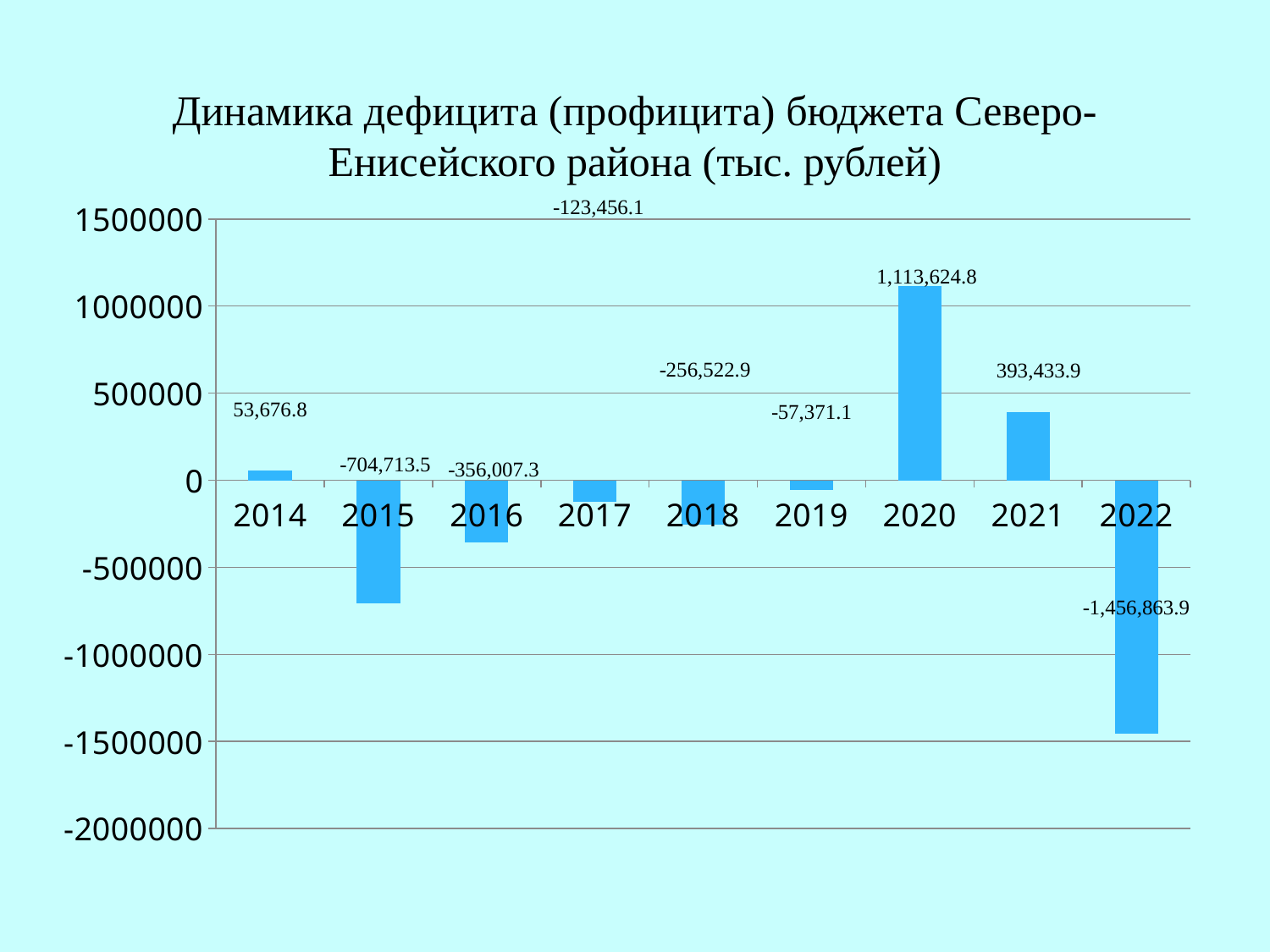
What kind of chart is this? Bar chart Which is larger, the value for 2021 or the value for 2014? 2021 Is the value for 2016 greater or less than -500000? greater What unit is given in the chart title? тыс. рублей What is the value for 2014? 53,676.8 Which year has the highest value? 2020 What is the difference between the values for 2020 and 2021? 720,190.9 What is the value for 2022? -1,456,863.9 How many years are shown on the x axis? 9 Which year has the lowest value? 2022 What is the value for 2020? 1,113,624.8 What is the value for 2015? -704,713.5